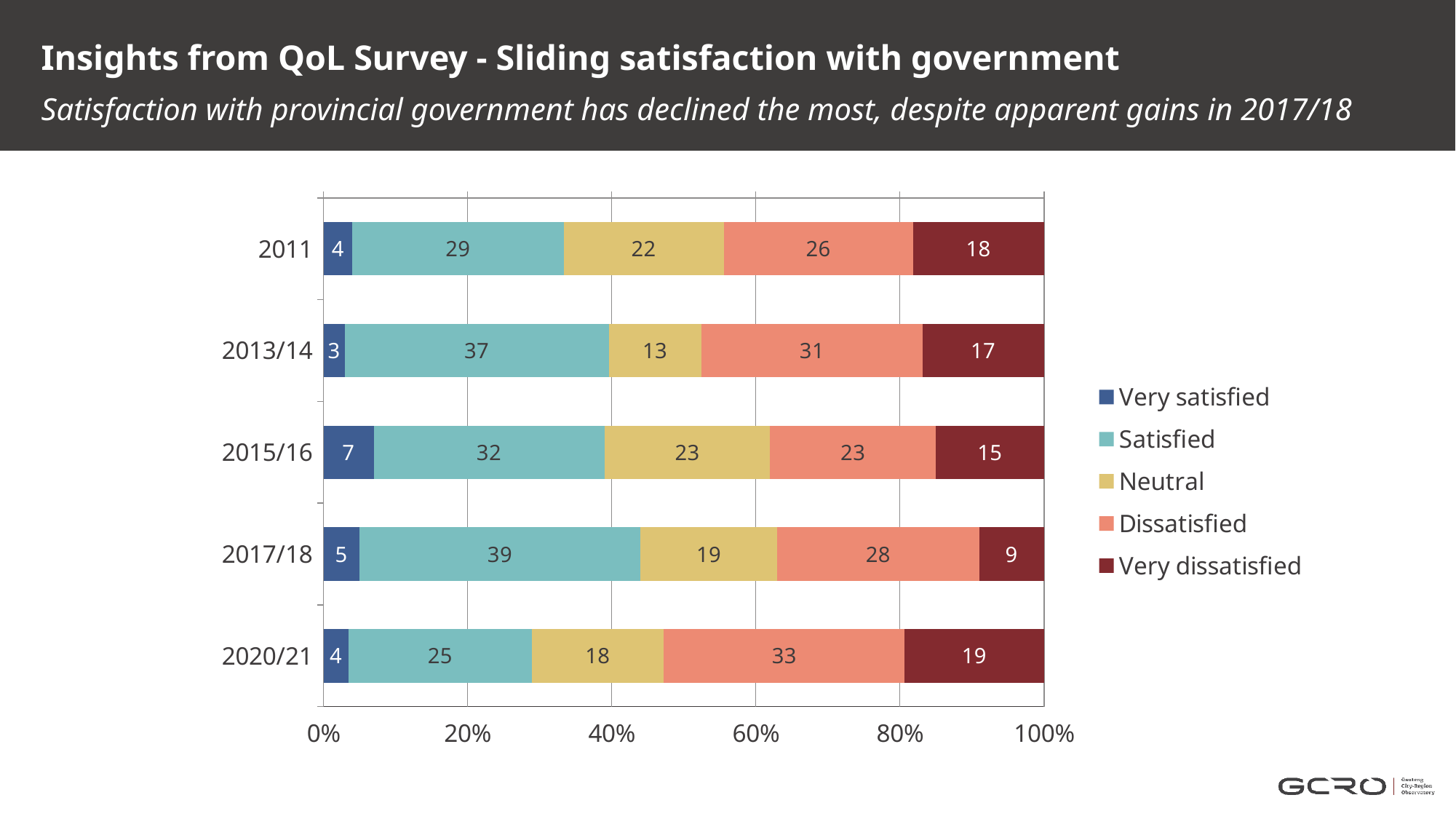
Which year has the highest Satisfied value? 2017/18 Which is larger, the Neutral value in 2015/16 or in 2013/14? 2015/16 How many series does the legend list? 5 Which legend entry is shown in dark red? Very dissatisfied What is the value for Satisfied in 2017/18? 39 What is the difference between the Dissatisfied value in 2020/21 and in 2011? 7 What is the value for Very satisfied in 2015/16? 7 Which year has the highest Dissatisfied value? 2020/21 What is the value for Very dissatisfied in 2020/21? 19 Which year has the lowest Very dissatisfied value? 2017/18 What kind of chart is shown on the slide? Stacked bar chart How many survey years are shown on the chart? 5